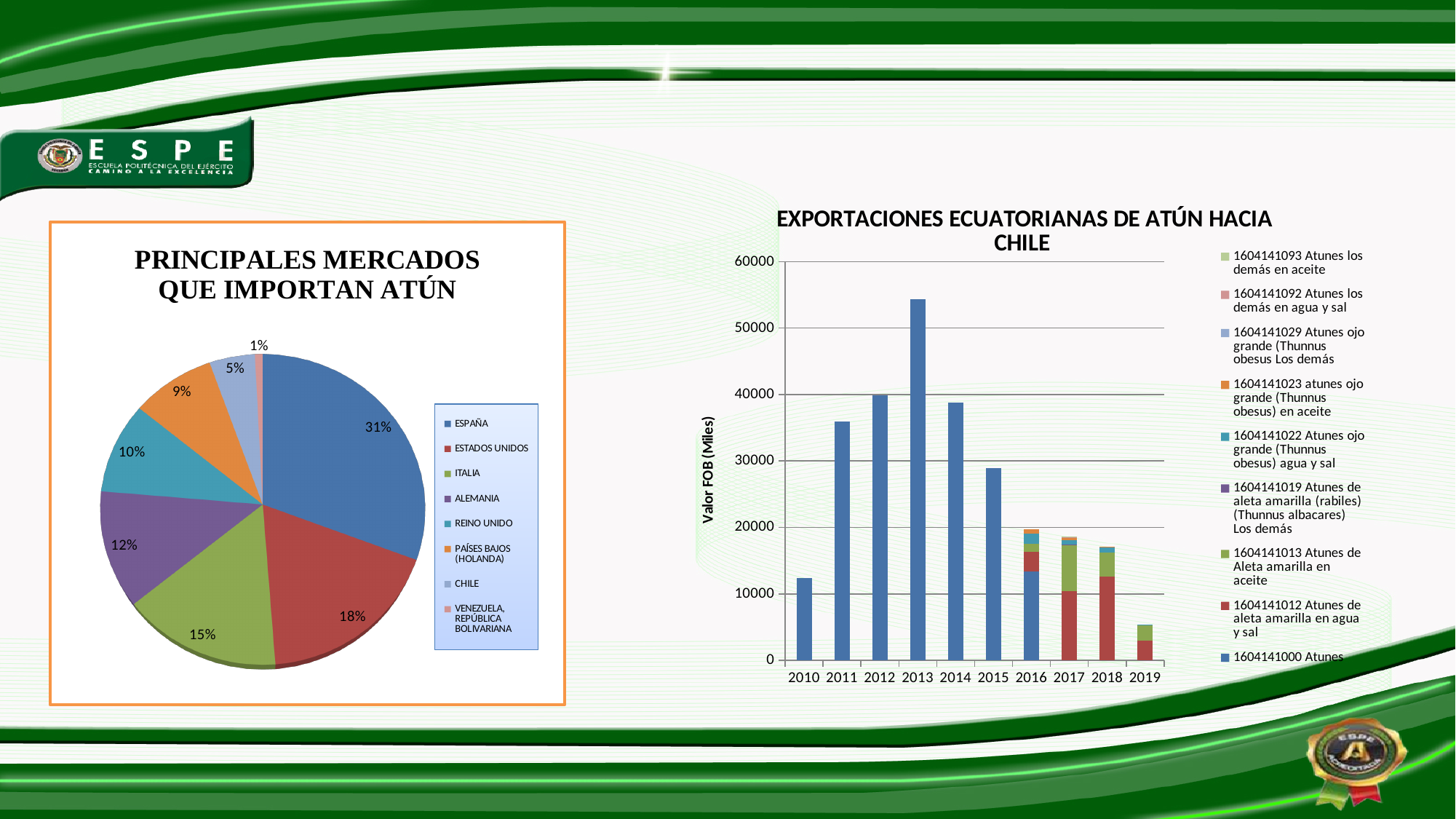
How many countries are shown in the pie chart 'PRINCIPALES MERCADOS QUE IMPORTAN ATÚN'? 8 How many series does the legend of the chart 'EXPORTACIONES ECUATORIANAS DE ATÚN HACIA CHILE' list? 9 In the chart 'EXPORTACIONES ECUATORIANAS DE ATÚN HACIA CHILE', do the total values rise or fall from 2013 to 2015? fall In the chart 'EXPORTACIONES ECUATORIANAS DE ATÚN HACIA CHILE', is the total value for 2019 greater or less than 10000? less In the chart 'EXPORTACIONES ECUATORIANAS DE ATÚN HACIA CHILE', which year has the highest total bar? 2013 What kind of chart is 'EXPORTACIONES ECUATORIANAS DE ATÚN HACIA CHILE'? Bar chart In the pie chart 'PRINCIPALES MERCADOS QUE IMPORTAN ATÚN', what share does ITALIA have? 15% In the pie chart 'PRINCIPALES MERCADOS QUE IMPORTAN ATÚN', what is the difference in percentage points between ESPAÑA and ESTADOS UNIDOS? 13 In the pie chart 'PRINCIPALES MERCADOS QUE IMPORTAN ATÚN', which country has the largest share? ESPAÑA In the pie chart 'PRINCIPALES MERCADOS QUE IMPORTAN ATÚN', which country has the smallest share? VENEZUELA, REPÚBLICA BOLIVARIANA In the pie chart 'PRINCIPALES MERCADOS QUE IMPORTAN ATÚN', what share does ESPAÑA have? 31% In the pie chart 'PRINCIPALES MERCADOS QUE IMPORTAN ATÚN', which has a larger share, ALEMANIA or REINO UNIDO? ALEMANIA